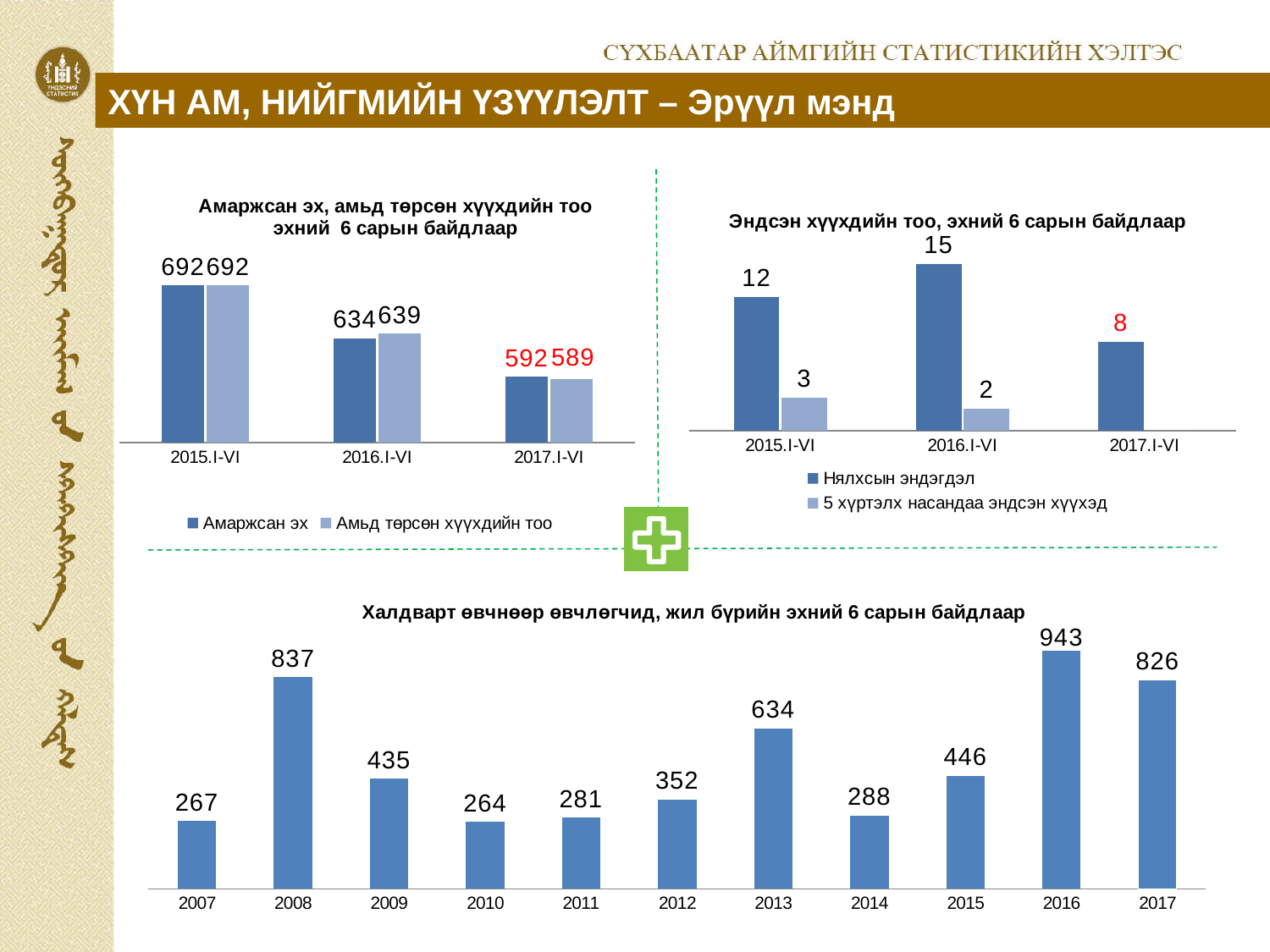
In the top-right chart 'Эндсэн хүүхдийн тоо, эхний 6 сарын байдлаар', what is the value of 'Нялхсын эндэгдэл' for 2016.I-VI? 15 In the bottom chart 'Халдварт өвчнөөр өвчлөгчид, жил бүрийн эхний 6 сарын байдлаар', which year has the lowest value? 2010 In the top-right chart 'Эндсэн хүүхдийн тоо, эхний 6 сарын байдлаар', what is the difference between 'Нялхсын эндэгдэл' for 2016.I-VI and 2017.I-VI? 7 In the bottom chart 'Халдварт өвчнөөр өвчлөгчид, жил бүрийн эхний 6 сарын байдлаар', which year has the highest value? 2016 In the top-left chart 'Амаржсан эх, амьд төрсөн хүүхдийн тоо эхний 6 сарын байдлаар', what is the value of 'Амьд төрсөн хүүхдийн тоо' for 2016.I-VI? 639 How many series does the legend of the top-left chart 'Амаржсан эх, амьд төрсөн хүүхдийн тоо эхний 6 сарын байдлаар' list? 2 What kind of chart is the bottom chart 'Халдварт өвчнөөр өвчлөгчид, жил бүрийн эхний 6 сарын байдлаар'? Bar chart In the top-left chart 'Амаржсан эх, амьд төрсөн хүүхдийн тоо эхний 6 сарын байдлаар', does the 'Амаржсан эх' series rise or fall from 2015.I-VI to 2017.I-VI? Fall In the bottom chart 'Халдварт өвчнөөр өвчлөгчид, жил бүрийн эхний 6 сарын байдлаар', what is the value for 2013? 634 How many years are shown in the bottom chart 'Халдварт өвчнөөр өвчлөгчид, жил бүрийн эхний 6 сарын байдлаар'? 11 In the bottom chart 'Халдварт өвчнөөр өвчлөгчид, жил бүрийн эхний 6 сарын байдлаар', what is the difference between the values for 2016 and 2017? 117 In the top-right chart 'Эндсэн хүүхдийн тоо, эхний 6 сарын байдлаар', which is larger for 2015.I-VI: 'Нялхсын эндэгдэл' or '5 хүртэлх насандаа эндсэн хүүхэд'? Нялхсын эндэгдэл